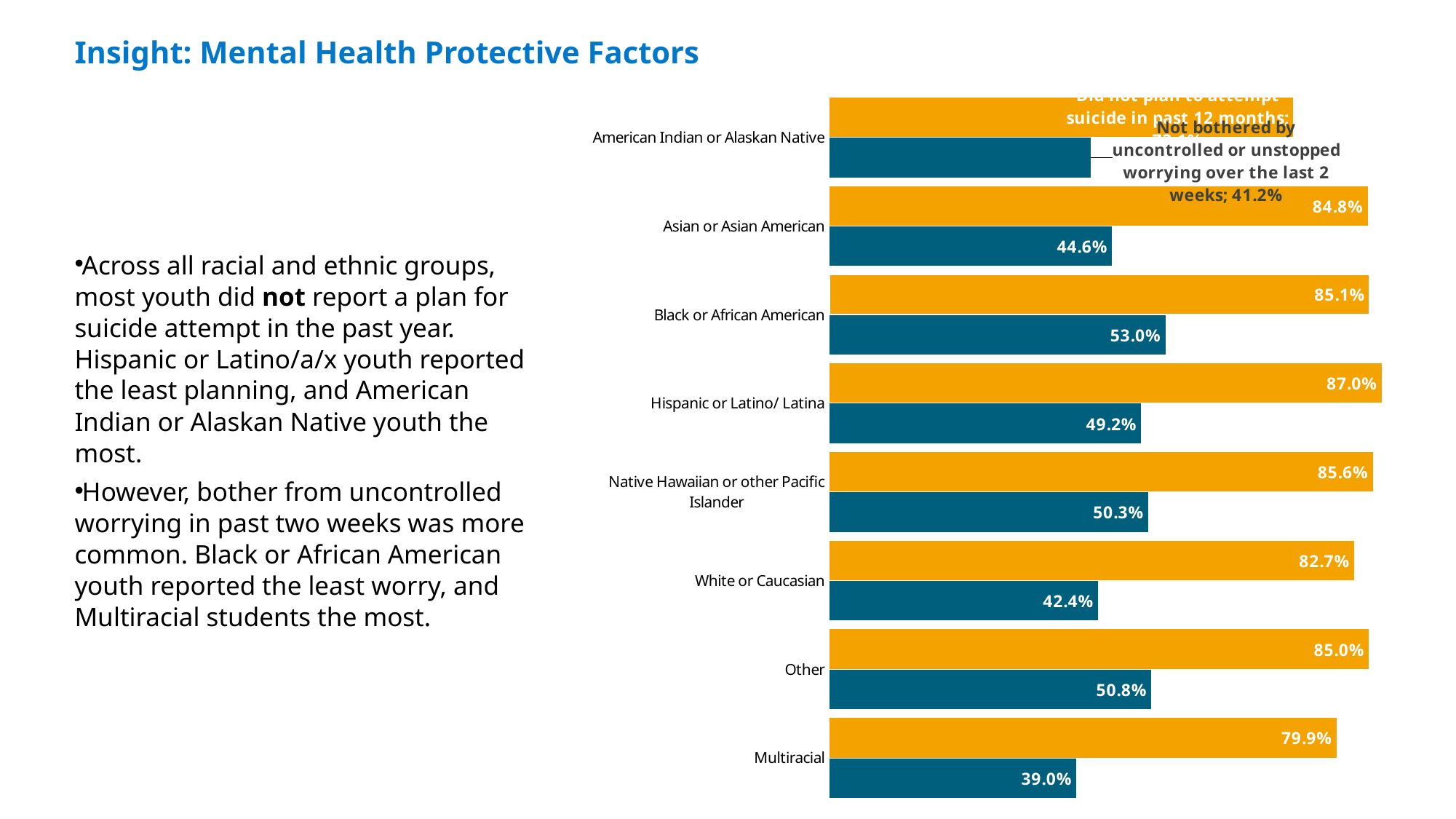
Which is larger: the 'Not bothered by uncontrolled or unstopped worrying' value for Black or African American youth or for Asian or Asian American youth? Black or African American What is the value for American Indian or Alaskan Native youth in the 'Not bothered by uncontrolled or unstopped worrying over the last 2 weeks' series? 41.2% How many racial or ethnic groups are shown on the chart? 8 What percentage of Multiracial youth were not bothered by uncontrolled or unstopped worrying over the last 2 weeks? 39.0% What is the difference between the Black or African American and Multiracial values for 'Not bothered by uncontrolled or unstopped worrying over the last 2 weeks'? 14.0 percentage points Which racial or ethnic group has the highest value for 'Not bothered by uncontrolled or unstopped worrying over the last 2 weeks'? Black or African American Which racial or ethnic group has the lowest value for 'Not bothered by uncontrolled or unstopped worrying over the last 2 weeks'? Multiracial What percentage of Hispanic or Latino/ Latina youth did not plan to attempt suicide in the past 12 months? 87.0% Which racial or ethnic group has the highest value for 'Did not plan to attempt suicide in past 12 months'? Hispanic or Latino/ Latina How many data series does the chart show? 2 What is the value for White or Caucasian youth in the 'Did not plan to attempt suicide in past 12 months' series? 82.7% What is the difference between the Hispanic or Latino/ Latina and White or Caucasian values for 'Did not plan to attempt suicide in past 12 months'? 4.3 percentage points